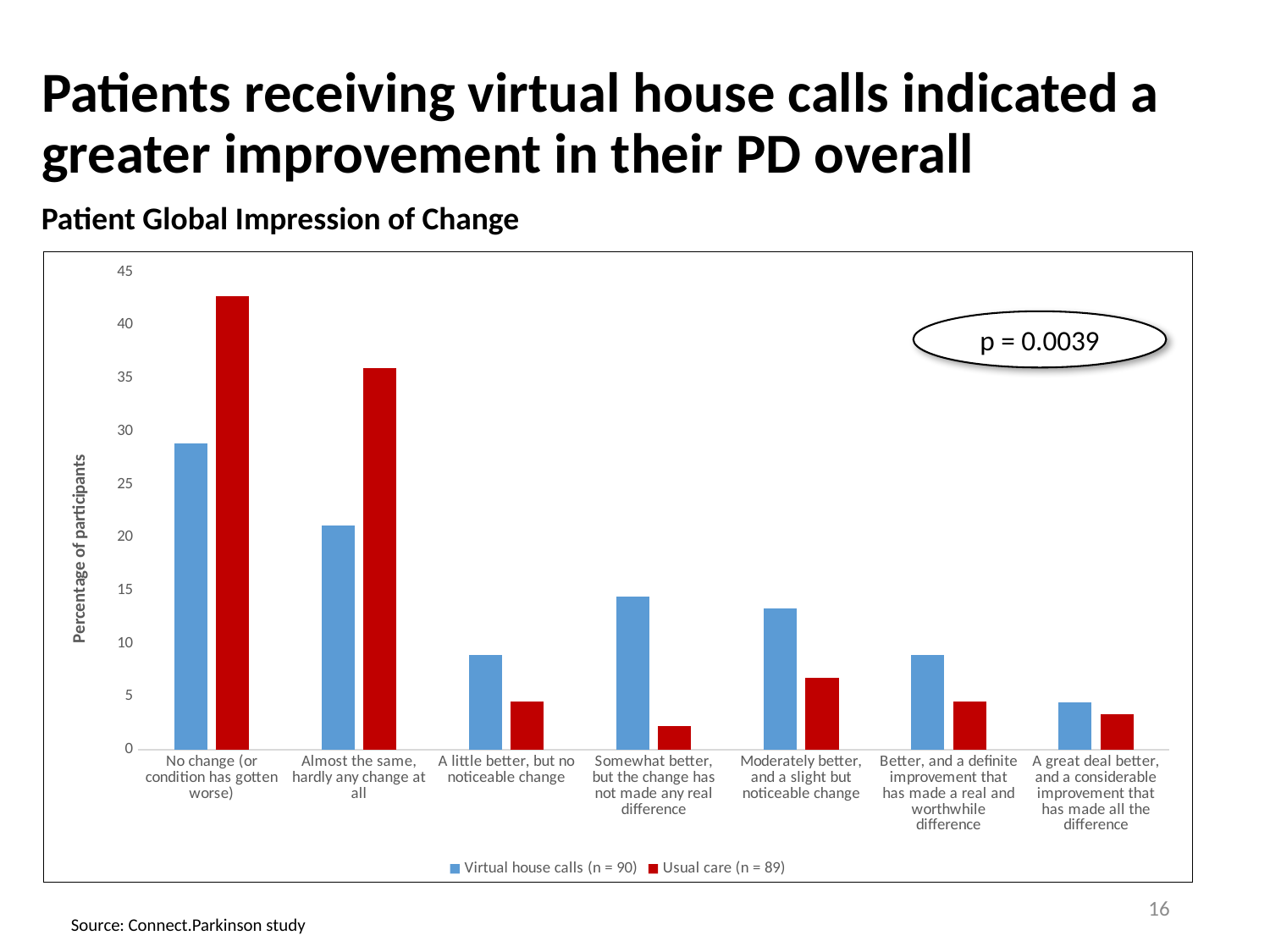
For which category is the Usual care (n = 89) bar highest? No change (or condition has gotten worse) What kind of chart is shown on the slide? Bar chart How many series does the legend list? 2 How many response categories are shown along the x axis? 7 What p-value is shown on the chart? p = 0.0039 Is the Virtual house calls (n = 90) value for 'Almost the same, hardly any change at all' greater or less than 25? less Is the Usual care (n = 89) value for 'No change (or condition has gotten worse)' greater or less than 40? greater For 'No change (or condition has gotten worse)', which series has the larger value? Usual care (n = 89) For which category is the Virtual house calls (n = 90) bar lowest? A great deal better, and a considerable improvement that has made all the difference For which category is the Virtual house calls (n = 90) bar highest? No change (or condition has gotten worse) For 'Somewhat better, but the change has not made any real difference', which series has the larger value? Virtual house calls (n = 90) For which category is the Usual care (n = 89) bar lowest? Somewhat better, but the change has not made any real difference